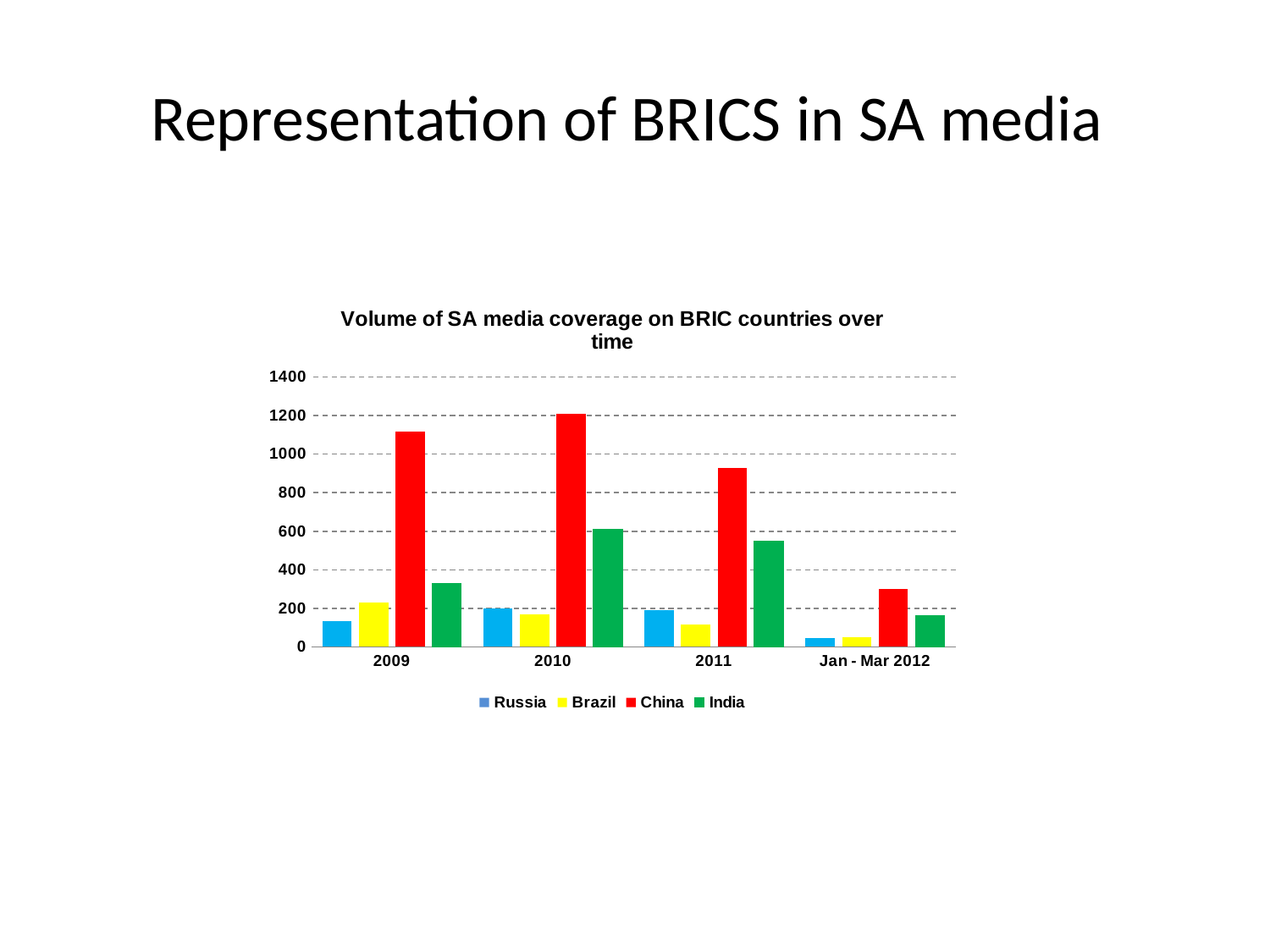
How many time periods are shown on the x axis? 4 Which country has the highest value in 2009? China In which period is the value for India highest? 2010 Is the value for China in 2009 greater or less than 1000? greater What is the title of the chart? Volume of SA media coverage on BRIC countries over time How many series does the legend list? 4 What kind of chart is shown on the slide? bar chart Is the value for China in 2011 greater or less than 1000? less Is the value for India in 2009 greater or less than 400? less Which is larger in 2010, the value for India or the value for Brazil? India In which period is the value for China lowest? Jan - Mar 2012 In which period is the value for China highest? 2010